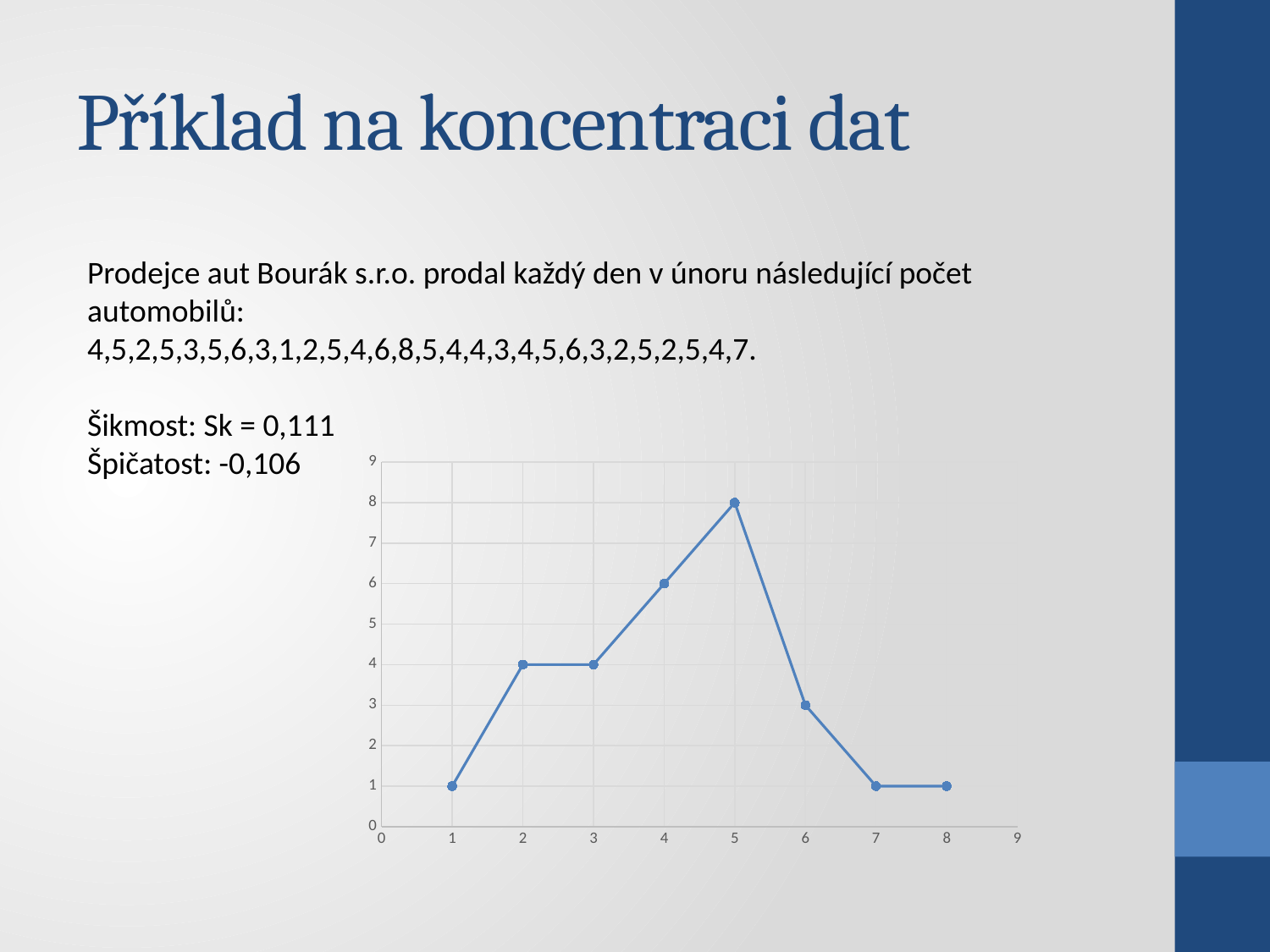
What kind of chart is shown on the slide? line chart Does the line rise or fall between x = 5 and x = 8? fall What is the y value at x = 4? 6 At which x value does the line reach its highest point? 5 Which has the larger y value, x = 4 or x = 6? x = 4 What is the y value at x = 5? 8 Is the y value at x = 5 greater or less than 7? greater What is the difference between the y values at x = 5 and x = 6? 5 What is the y value at x = 6? 3 What is the y value at x = 2? 4 What is the highest value shown on the y axis? 9 How many data points are plotted on the chart? 8